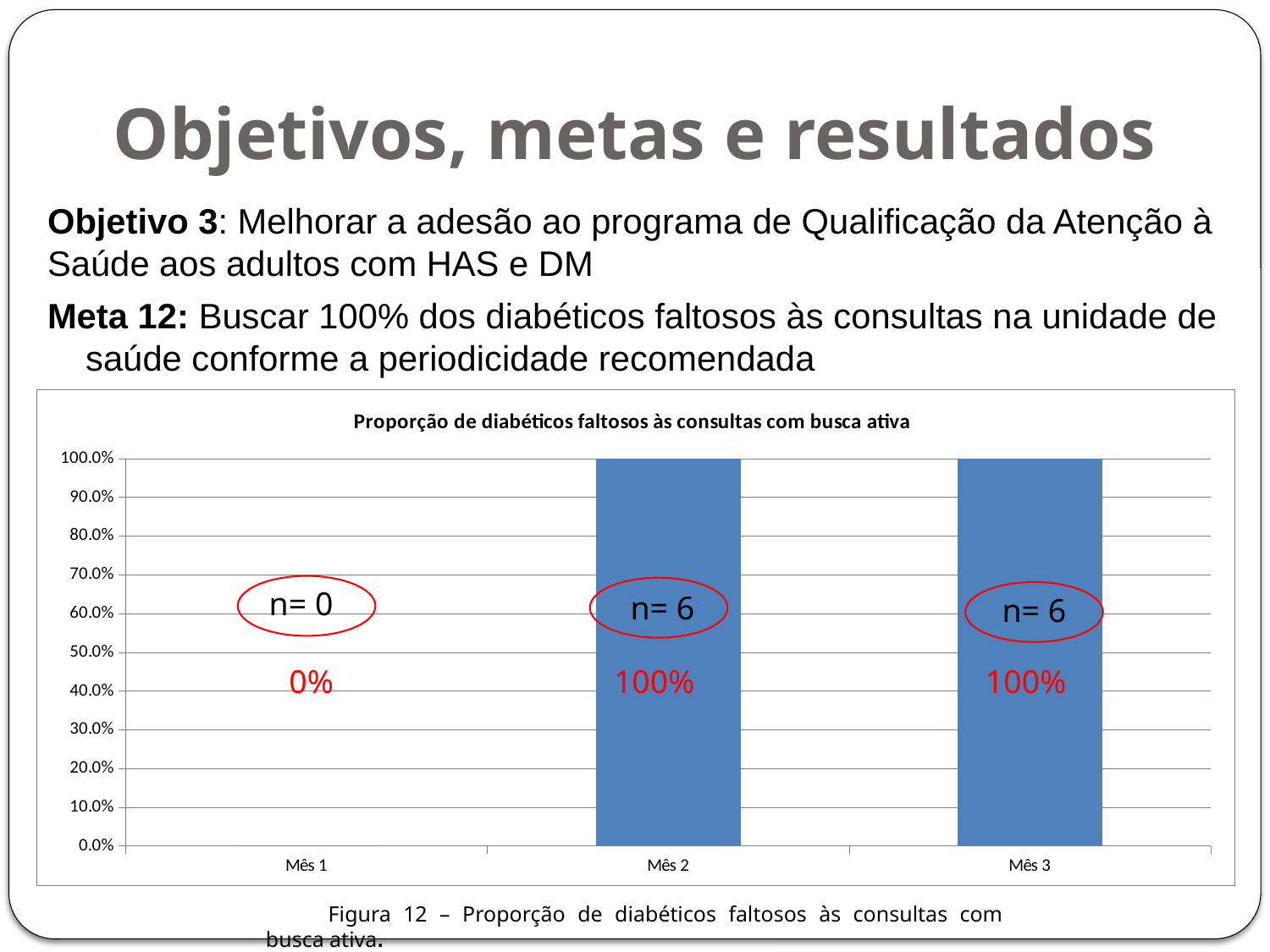
Which is larger, the value for Mês 1 or the value for Mês 3? Mês 3 Which month has the lowest value? Mês 1 What is the difference between the values for Mês 2 and Mês 1? 100% What is the title of the chart? Proporção de diabéticos faltosos às consultas com busca ativa What is the value for Mês 2? 100% What is the n value annotated for Mês 2? n= 6 What kind of chart is shown? bar chart Do the values rise or fall from Mês 1 to Mês 2? rise What is the value for Mês 3? 100% What is the value for Mês 1? 0% Is the value for Mês 2 greater or less than 50.0%? greater How many months are shown on the x axis? 3